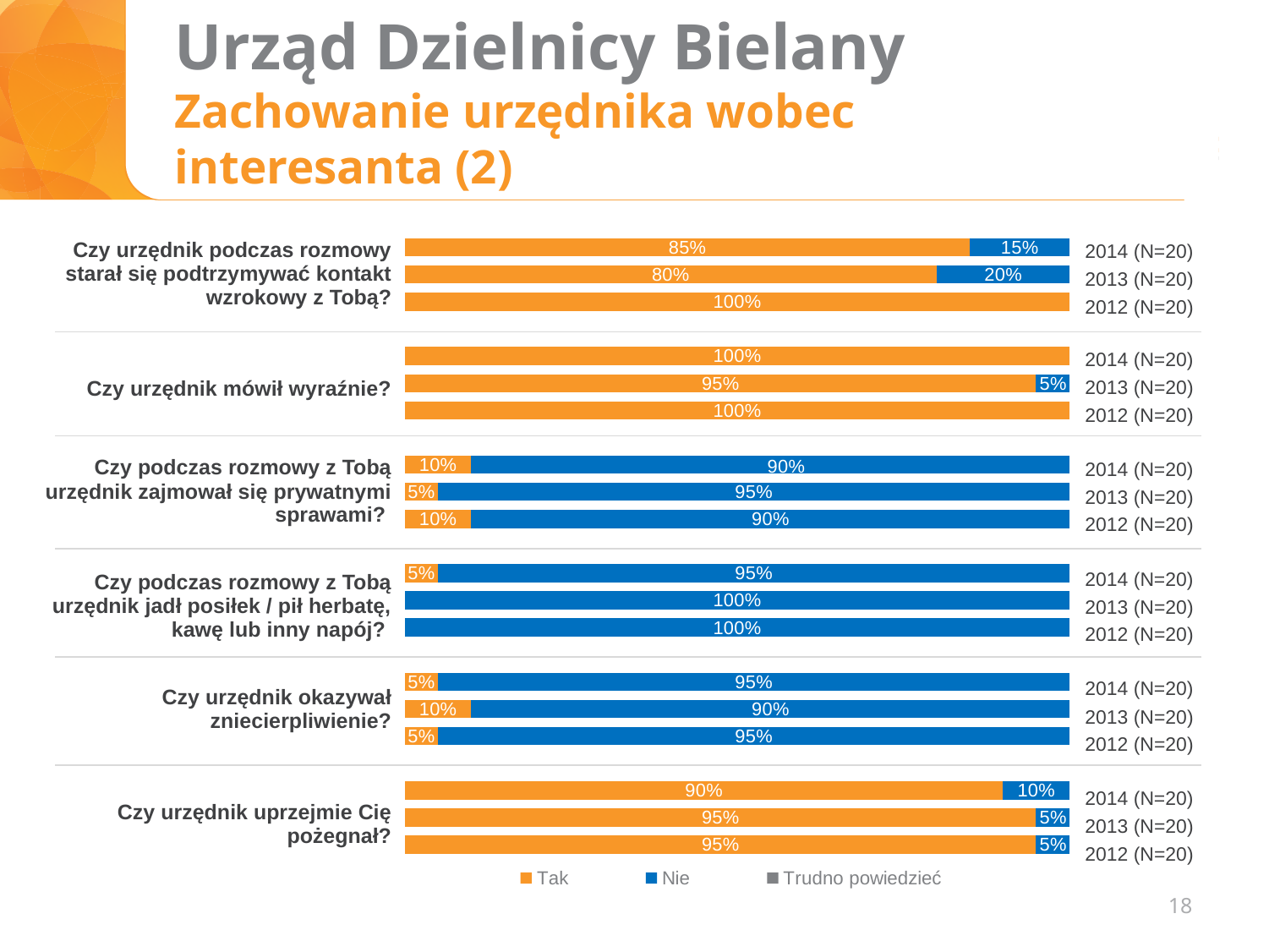
For "Czy urzędnik podczas rozmowy starał się podtrzymywać kontakt wzrokowy z Tobą?", which year had the highest "Tak" share? 2012 What share answered "Nie" in 2013 to "Czy urzędnik podczas rozmowy starał się podtrzymywać kontakt wzrokowy z Tobą?"? 20% What kind of chart is shown on the slide? Stacked bar chart Which colour represents "Nie" in the chart? Blue What share answered "Tak" in 2014 to "Czy urzędnik uprzejmie Cię pożegnał?"? 90% What share answered "Nie" in 2013 to "Czy urzędnik mówił wyraźnie?"? 5% What share answered "Tak" in 2014 to "Czy podczas rozmowy z Tobą urzędnik zajmował się prywatnymi sprawami?"? 10% How many series does the legend list? 3 For "Czy urzędnik podczas rozmowy starał się podtrzymywać kontakt wzrokowy z Tobą?", what is the difference between the "Tak" share in 2014 and in 2013? 5% For "Czy urzędnik uprzejmie Cię pożegnał?", is the "Nie" share larger in 2014 or in 2013? 2014 What share answered "Tak" in 2014 to "Czy urzędnik podczas rozmowy starał się podtrzymywać kontakt wzrokowy z Tobą?"? 85% What share answered "Nie" in 2013 to "Czy urzędnik okazywał zniecierpliwienie?"? 90%